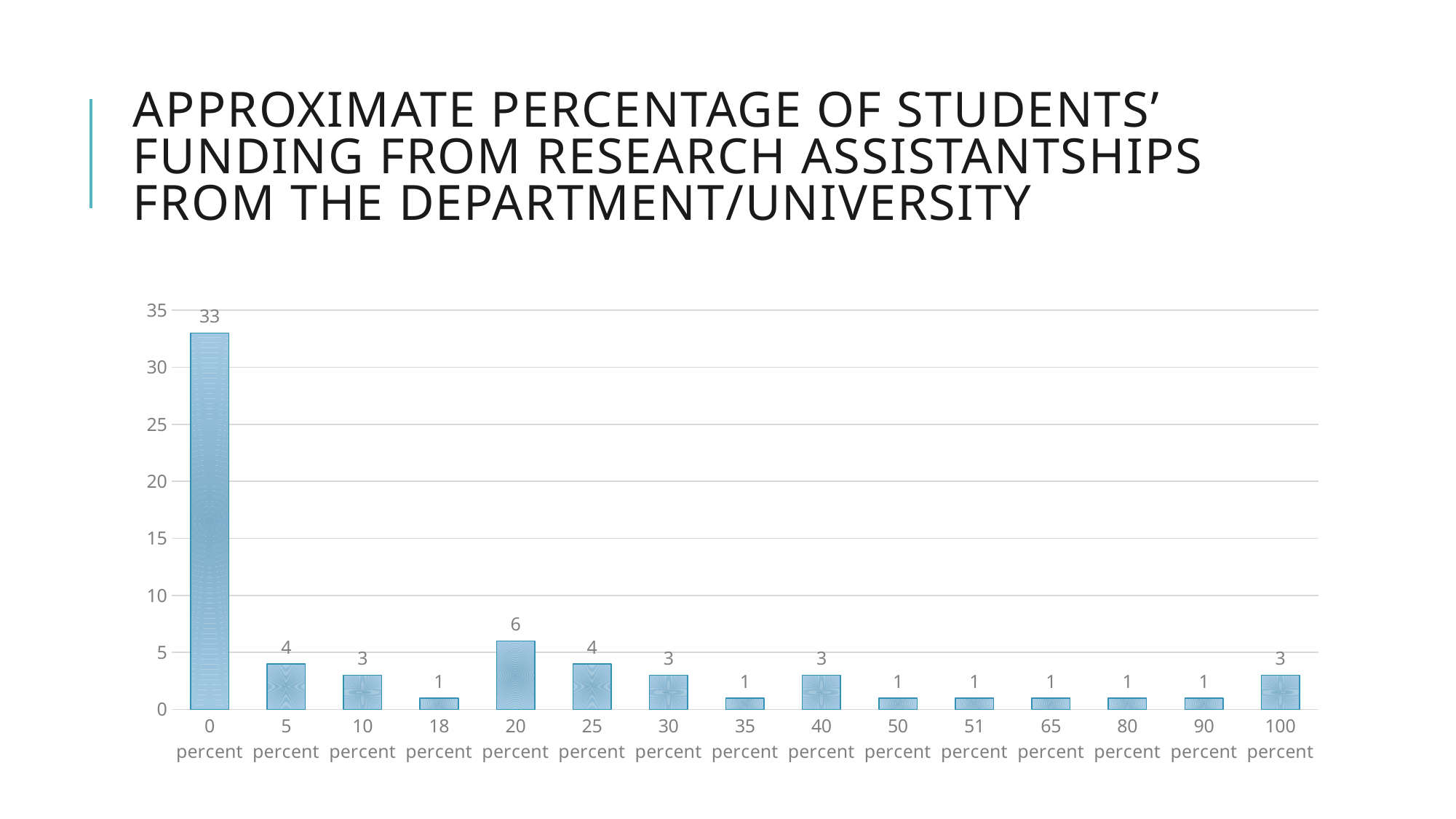
What is the value for the 20 percent category? 6 What is the value for the 18 percent category? 1 What is the value for the 100 percent category? 3 What is the difference between the values for 5 percent and 10 percent? 1 How many categories are shown on the x axis? 15 What is the value for the 0 percent category? 33 What is the difference between the values for 0 percent and 20 percent? 27 Is the value for 0 percent greater or less than 30? greater What kind of chart is shown on the slide? bar chart Which category has the highest value? 0 percent What is the highest value shown on the y axis? 35 Which is larger, the value for 20 percent or the value for 25 percent? 20 percent